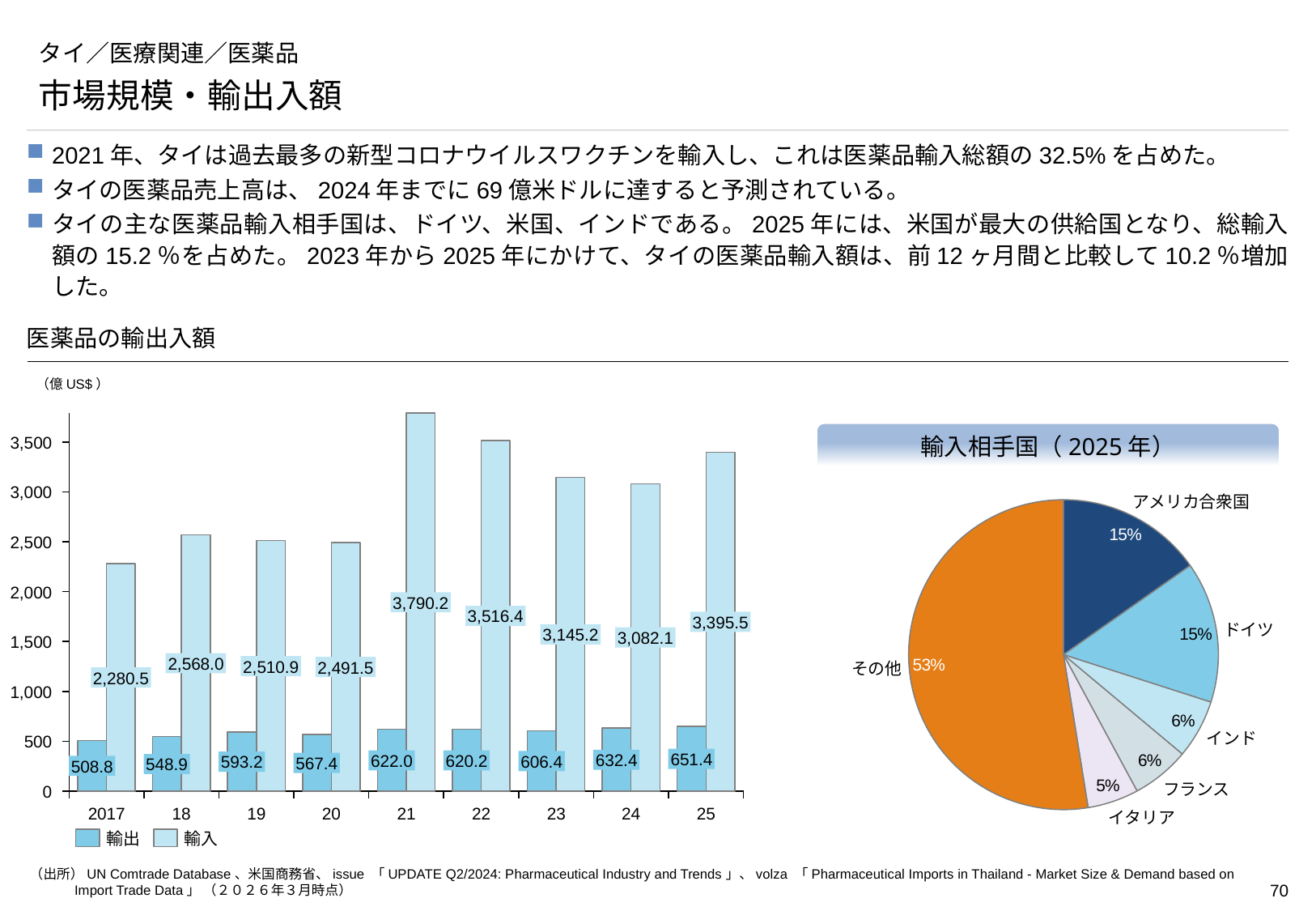
What kind of chart is 輸入相手国（2025年）? pie chart In the bar chart 医薬品の輸出入額, is the 輸出 value for 2025 larger or smaller than the 輸出 value for 2023? larger In the bar chart 医薬品の輸出入額, which year has the highest 輸入 value? 21 In the bar chart 医薬品の輸出入額, how many series does the legend list? 2 In the pie chart 輸入相手国（2025年）, what share does ドイツ have? 15% In the pie chart 輸入相手国（2025年）, which category has the smallest share? イタリア In the bar chart 医薬品の輸出入額, which year has the lowest 輸出 value? 2017 In the bar chart 医薬品の輸出入額, what is the difference between the 輸入 values for 2025 and 2024? 313.4 In the bar chart 医薬品の輸出入額, what is the 輸入 value for 2021? 3,790.2 In the pie chart 輸入相手国（2025年）, what share does その他 have? 53% In the bar chart 医薬品の輸出入額, what is the 輸出 value for 2017? 508.8 In the bar chart 医薬品の輸出入額, how many years are shown on the x axis? 9